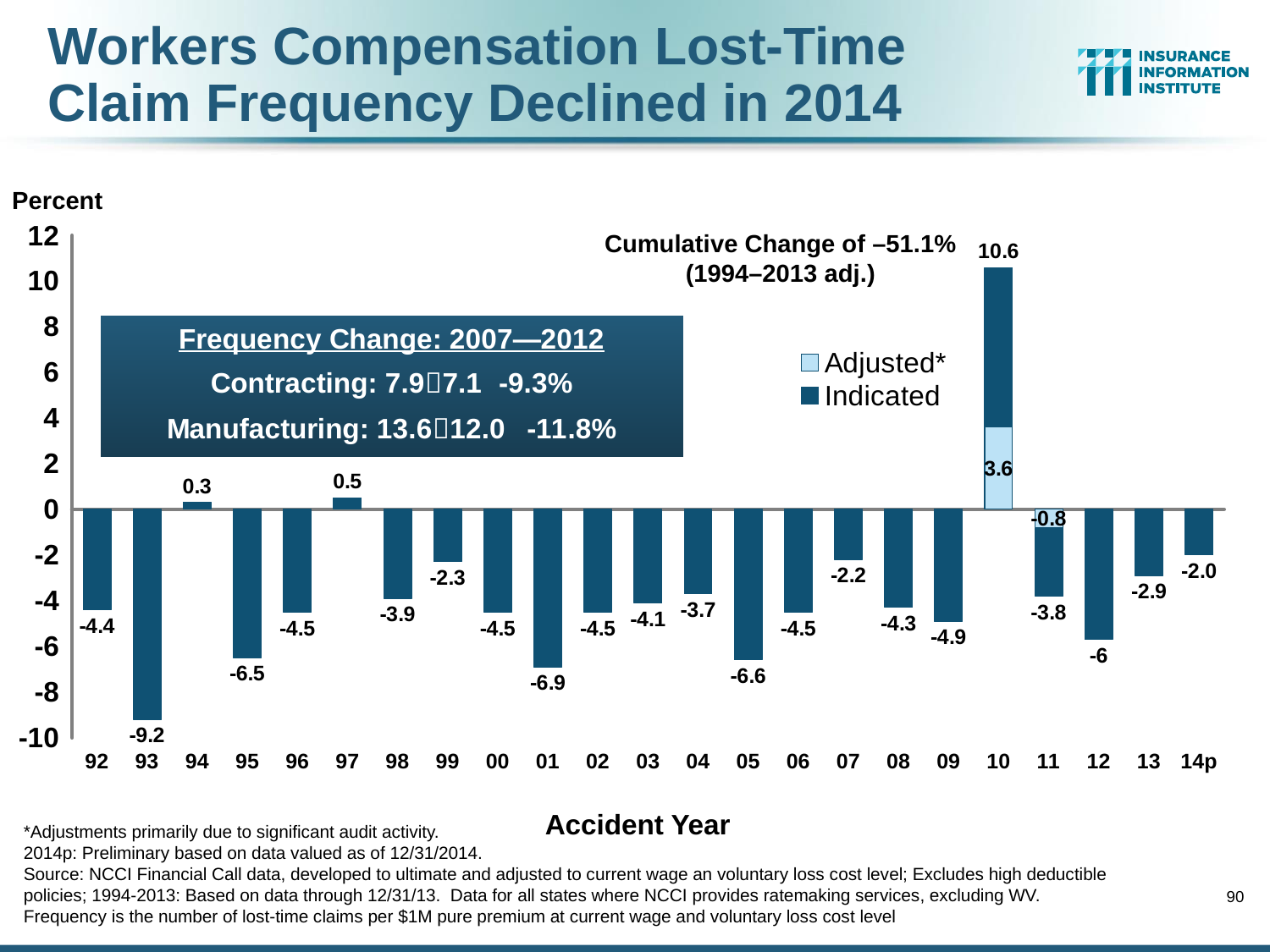
What is the Adjusted value for accident year 10? 3.6 What is the Indicated value for accident year 10? 10.6 How many series does the legend list? 2 What is the value for accident year 93? -9.2 What is the Adjusted value for accident year 11? -0.8 Which accident year has the highest value? 10 What is the value for accident year 14p? -2.0 How many accident years are shown on the x axis? 23 Which accident year has the lowest value? 93 Which accident year has a larger value, 97 or 94? 97 What kind of chart is shown on the slide? Bar chart What is the difference between the values for accident years 01 and 12? 0.9